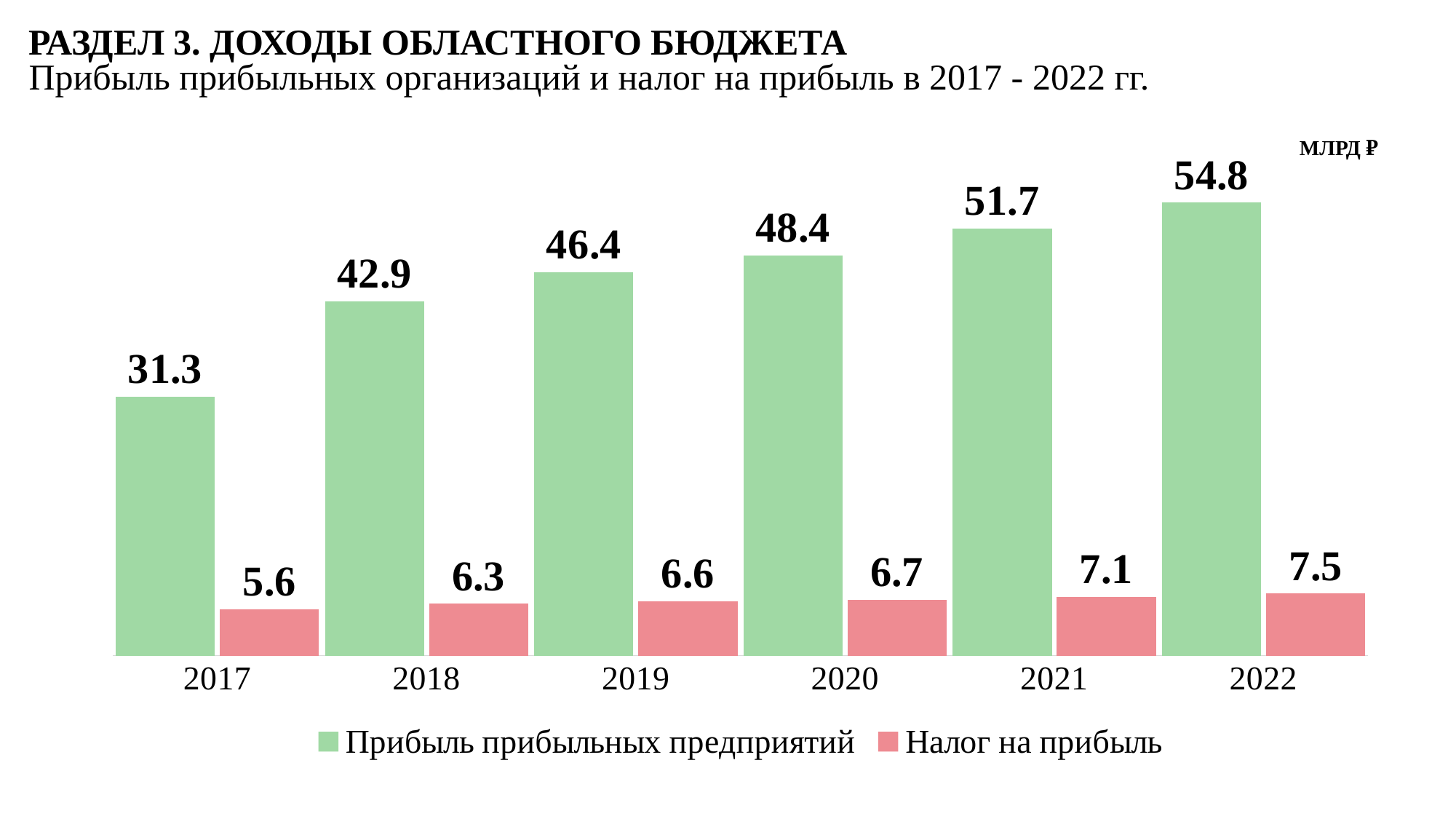
What is the value of Прибыль прибыльных предприятий for 2017? 31.3 Which year has the highest value for Налог на прибыль? 2022 What is the difference between Прибыль прибыльных предприятий in 2022 and in 2017? 23.5 Do the values for Налог на прибыль rise or fall from 2017 to 2022? Rise Which is larger: Прибыль прибыльных предприятий in 2019 or in 2020? 2020 How many years are shown on the x axis? 6 What is the value of Налог на прибыль for 2020? 6.7 How many series does the legend list? 2 Which year has the lowest value for Прибыль прибыльных предприятий? 2017 What is the value of Прибыль прибыльных предприятий for 2022? 54.8 What kind of chart is shown on the slide? Bar chart What is the difference between Налог на прибыль in 2019 and in 2018? 0.3